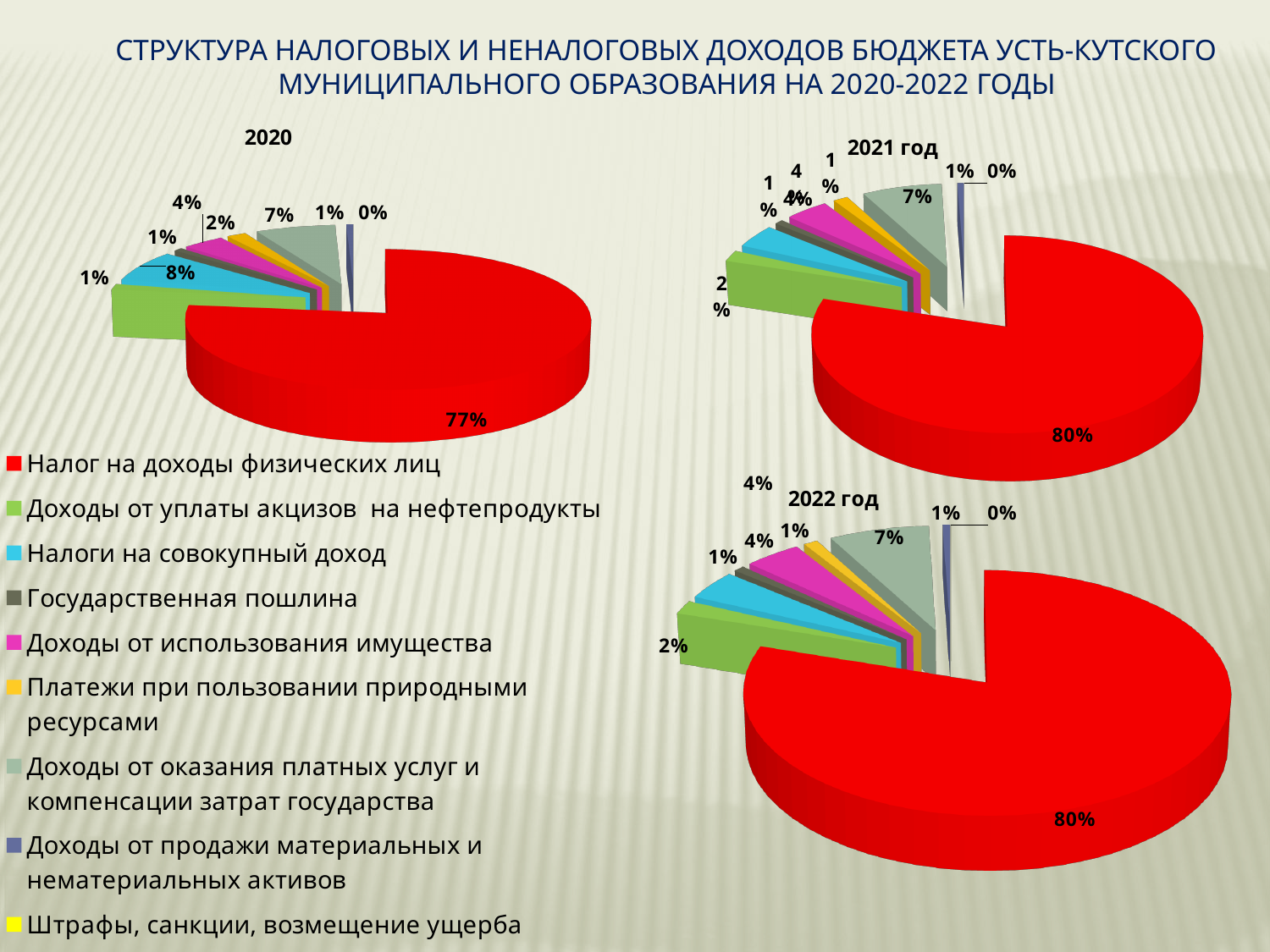
What kind of charts are shown on the slide? Pie charts In the 2022 год pie chart, what share is shown for Доходы от оказания платных услуг и компенсации затрат государства? 7% In the 2020 pie chart, which category has the largest slice? Налог на доходы физических лиц By how many percentage points is the share of Налог на доходы физических лиц in 2021 год larger than in 2020? 3 How many categories does the legend list? 9 In the 2022 год pie chart, what share is shown for Штрафы, санкции, возмещение ущерба? 0% How many pie charts are on the slide? 3 In the 2020 pie chart, what share is shown for Налог на доходы физических лиц? 77% What colour represents Налог на доходы физических лиц in the legend? Red Which year shows a larger share for Налог на доходы физических лиц, 2020 or 2021 год? 2021 год